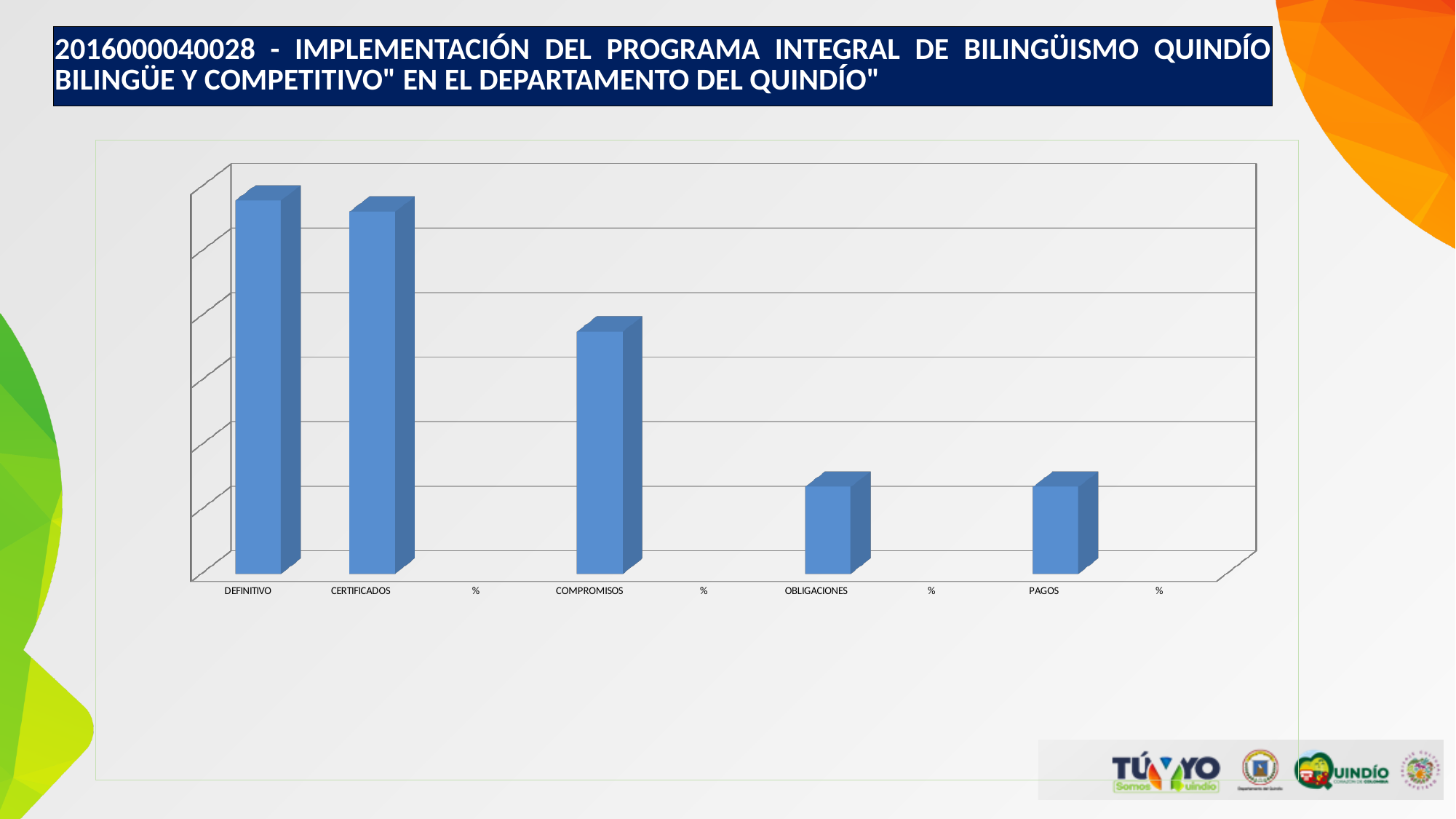
How many visible bars does the chart have? 5 What kind of chart is shown on the slide? bar chart What is the project code shown at the start of the slide title? 2016000040028 Do the bar heights generally rise or fall from left to right across the chart? fall What colour are the bars in the chart? blue Which is larger, the value for DEFINITIVO or the value for CERTIFICADOS? DEFINITIVO Is the bar for DEFINITIVO taller or shorter than the bar for COMPROMISOS? taller Which is larger, the value for COMPROMISOS or the value for PAGOS? COMPROMISOS Which category has the tallest bar in the chart? DEFINITIVO How many category labels are shown along the x axis of the chart? 9